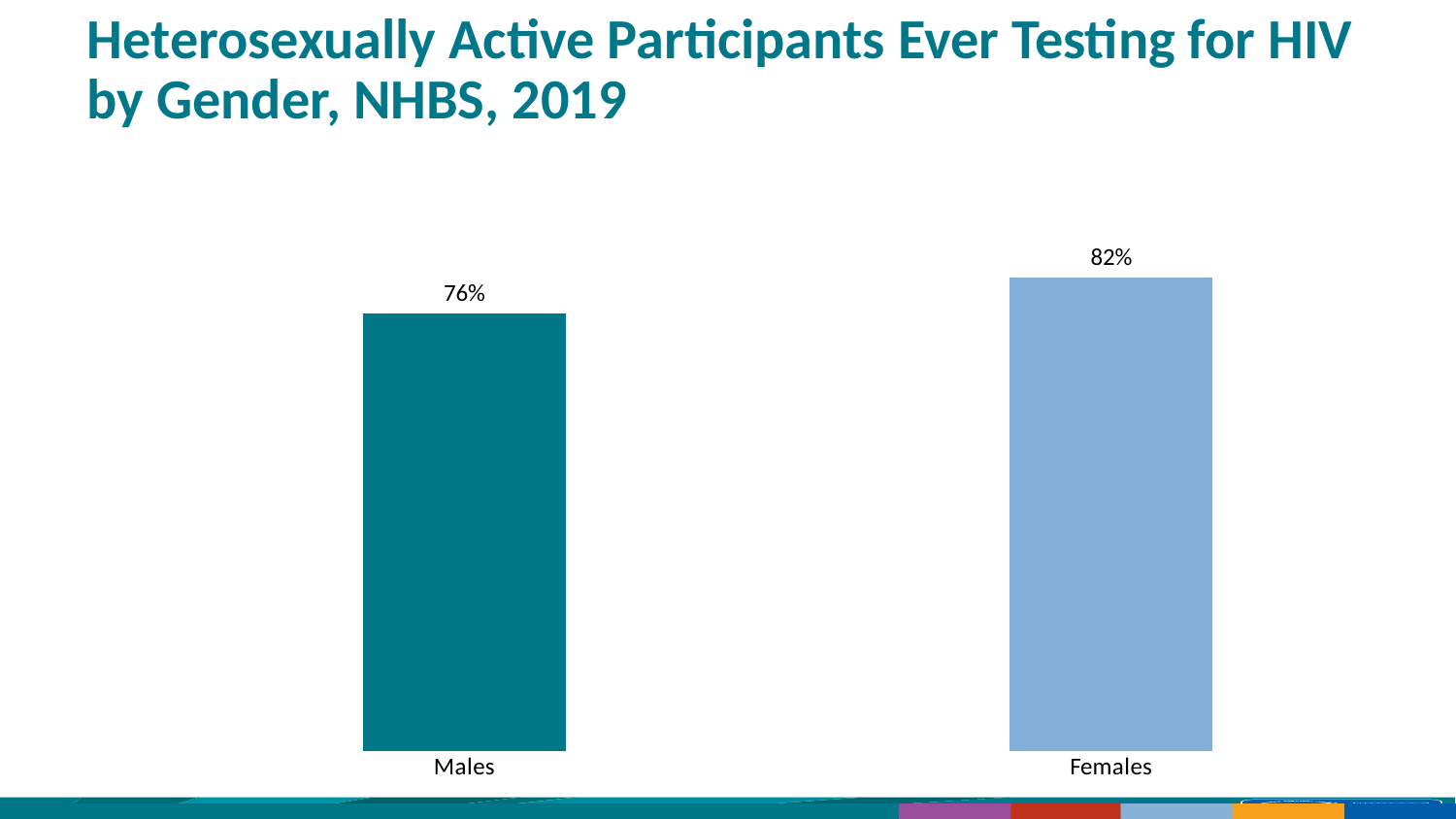
Which gender has the lower percentage of participants ever testing for HIV? Males Which gender has the higher percentage of participants ever testing for HIV? Females What percentage of heterosexually active female participants had ever tested for HIV? 82% What is the title of the chart on the slide? Heterosexually Active Participants Ever Testing for HIV by Gender, NHBS, 2019 What percentage of heterosexually active male participants had ever tested for HIV? 76% What year of NHBS data does the chart present? 2019 Is the value for Males larger or smaller than the value for Females? smaller What type of chart is shown on the slide? Bar chart What is the difference in percentage points between Females and Males for ever testing for HIV? 6 percentage points How many gender categories are shown in the chart? 2